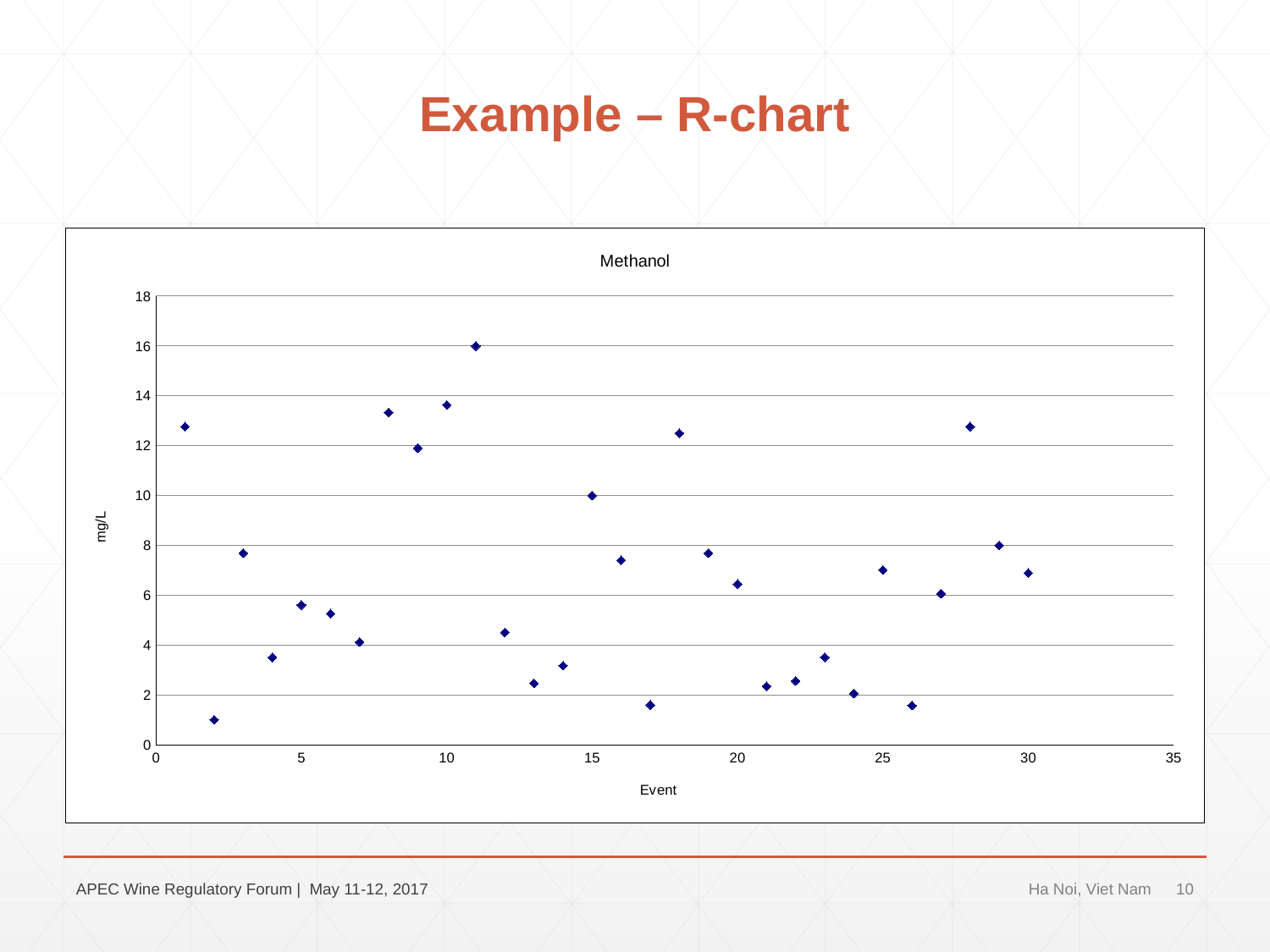
What kind of chart is shown on the slide? scatter chart Which event has the lowest methanol value? 2 Which has the larger value, event 8 or event 9? event 8 Is the value for event 10 greater or less than 12? greater Is the value for event 17 greater or less than 2? less Which has the larger value, event 1 or event 2? event 1 How many data points are plotted on the chart? 30 What is the methanol value (mg/L) at event 11? 16 What is the title of the chart? Methanol Which event has the highest methanol value? 11 What is the label of the y axis? mg/L What is the methanol value (mg/L) at event 15? 10